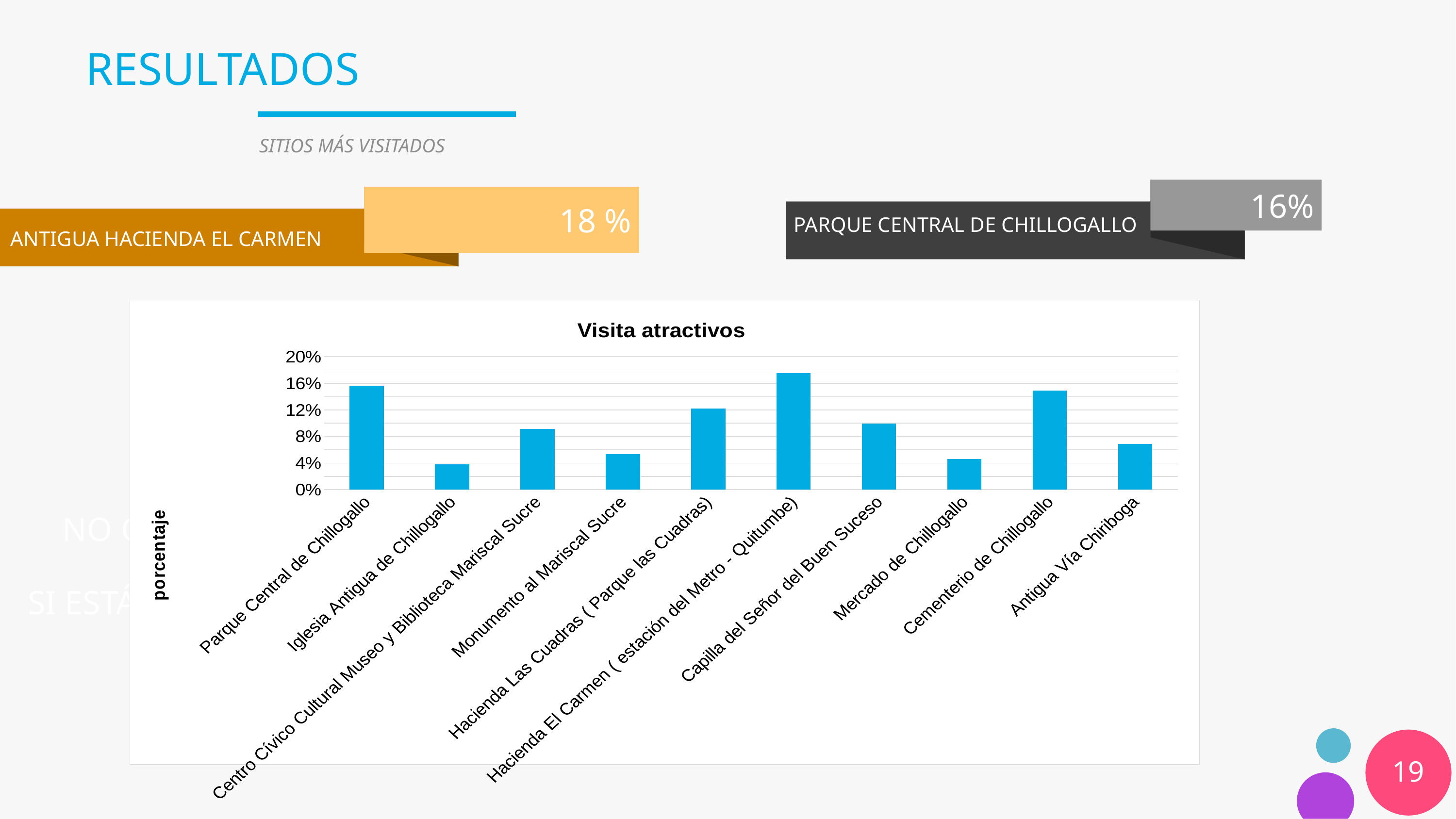
Is the value for Monumento al Mariscal Sucre greater or less than 8%? less How many categories (attractions) are plotted in the "Visita atractivos" chart? 10 What is the title of the chart on the slide? Visita atractivos What type of chart is shown under the title "Visita atractivos"? bar chart Is the value for Parque Central de Chillogallo greater or less than 12%? greater Is the value for Hacienda El Carmen ( estación del Metro - Quitumbe) greater or less than 16%? greater Which has a larger value: Hacienda Las Cuadras ( Parque las Cuadras) or Capilla del Señor del Buen Suceso? Hacienda Las Cuadras ( Parque las Cuadras) Which attraction has the lowest bar in the "Visita atractivos" chart? Iglesia Antigua de Chillogallo What is the label on the vertical axis of the "Visita atractivos" chart? porcentaje Which attraction has the highest bar in the "Visita atractivos" chart? Hacienda El Carmen ( estación del Metro - Quitumbe)